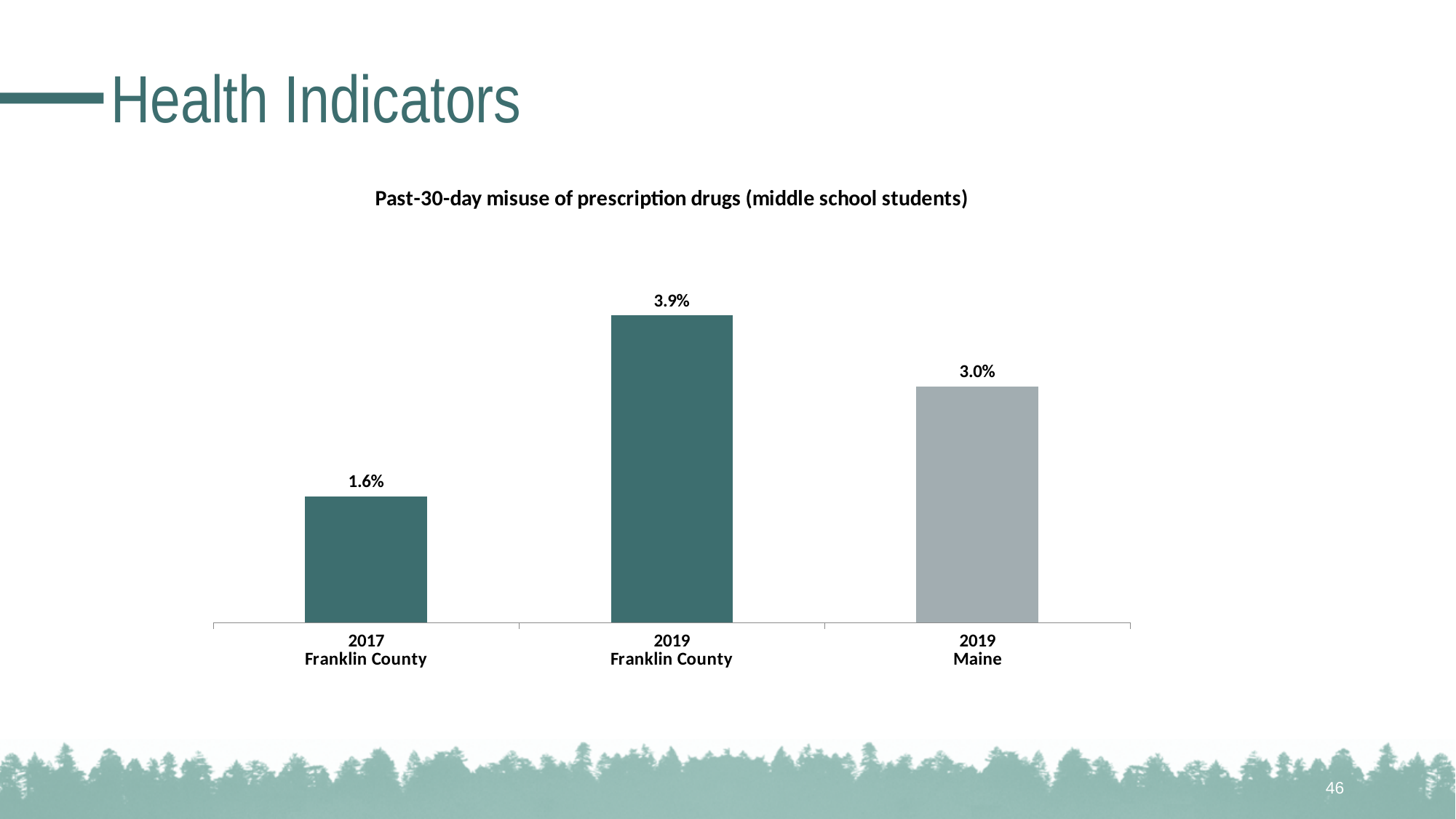
How many bars are shown in the chart? 3 Which category has the lowest value? 2017 Franklin County What is the value for 2019 Maine? 3.0% What is the difference between the 2019 Franklin County value and the 2019 Maine value? 0.9% What is the title of the chart? Past-30-day misuse of prescription drugs (middle school students) Which is larger, the value for 2019 Franklin County or the value for 2019 Maine? 2019 Franklin County What is the difference between the 2019 Franklin County value and the 2017 Franklin County value? 2.3% Which category has the highest value? 2019 Franklin County What kind of chart is shown on the slide? Bar chart Did the Franklin County value rise or fall from 2017 to 2019? Rise What is the value for 2017 Franklin County? 1.6% What is the value for 2019 Franklin County? 3.9%